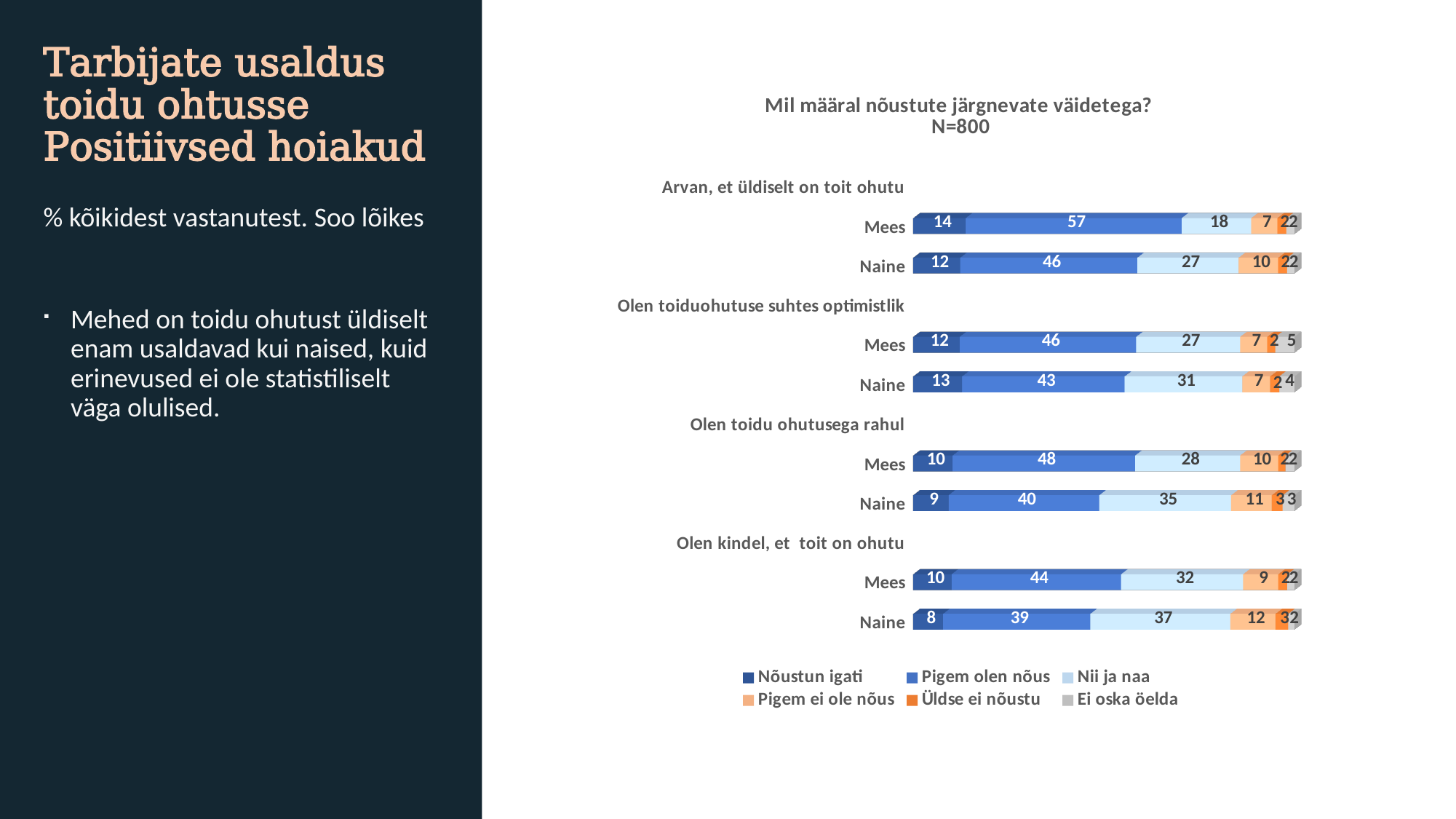
Under 'Olen toidu ohutusega rahul', which has the larger 'Nii ja naa' value, Mees or Naine? Naine How many series does the legend list? 6 What is the sample size (N) stated in the chart title? N=800 Which bar has the highest 'Pigem olen nõus' value? Mees, Arvan, et üldiselt on toit ohutu What is the 'Ei oska öelda' value for Mees under 'Olen toiduohutuse suhtes optimistlik'? 5 What is the difference between the 'Pigem olen nõus' values for Mees and Naine under 'Arvan, et üldiselt on toit ohutu'? 11 What is the 'Nii ja naa' value for Naine under 'Olen kindel, et toit on ohutu'? 37 How many bars are plotted in the chart? 8 What kind of chart is shown on the slide? Stacked bar chart Which bar has the lowest 'Nõustun igati' value? Naine, Olen kindel, et toit on ohutu What is the 'Pigem olen nõus' value for Mees under 'Arvan, et üldiselt on toit ohutu'? 57 What is the 'Nõustun igati' value for Naine under 'Olen toiduohutuse suhtes optimistlik'? 13